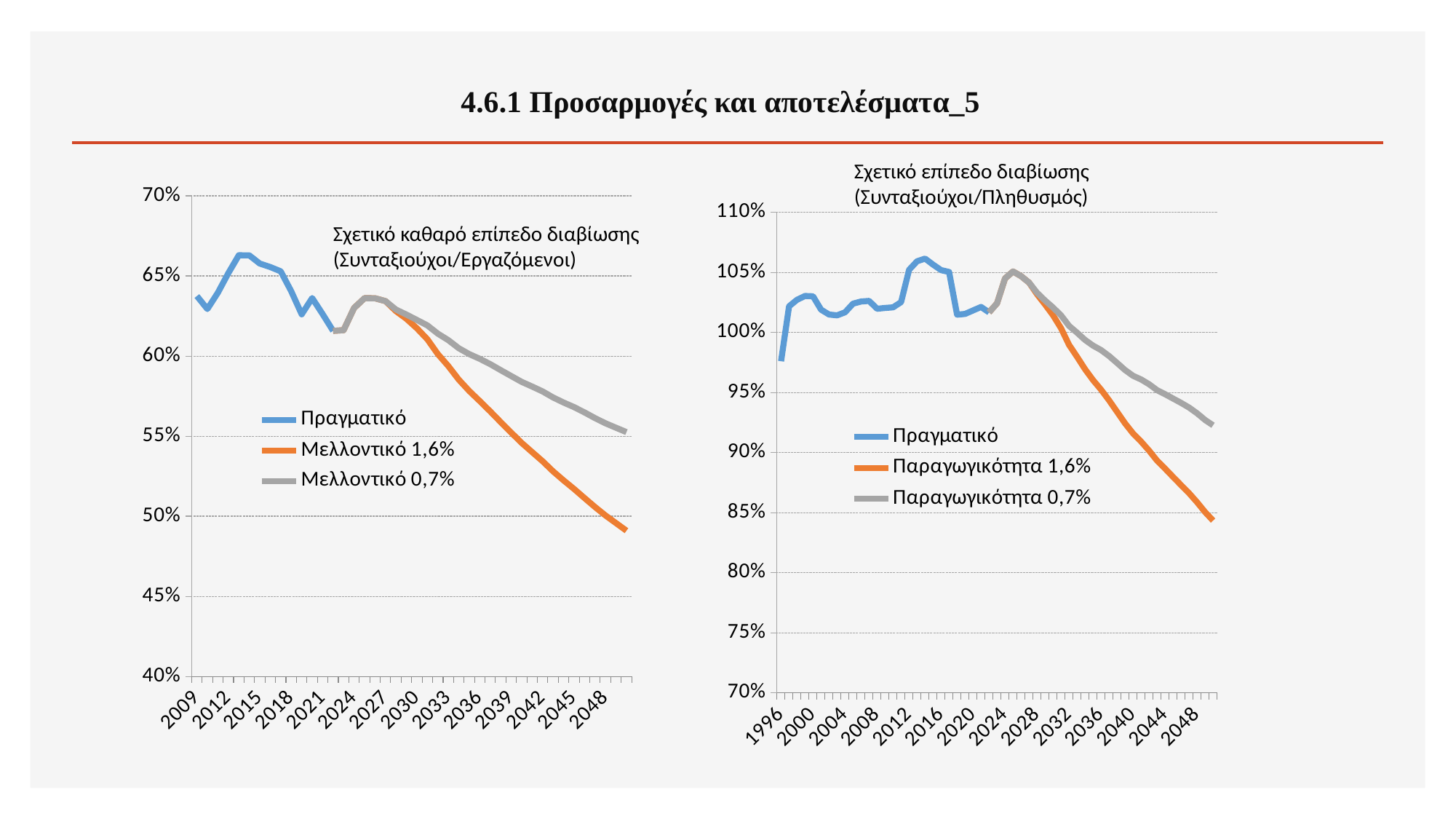
In the left chart (Σχετικό καθαρό επίπεδο διαβίωσης), is the final value of the Μελλοντικό 0,7% series greater or less than 60%? less In the right chart (Σχετικό επίπεδο διαβίωσης), is the final value of the Παραγωγικότητα 0,7% series greater or less than 90%? greater What kind of chart is the left chart (Σχετικό καθαρό επίπεδο διαβίωσης)? Line chart How many series does the legend of the right chart (Σχετικό επίπεδο διαβίωσης) list? 3 How many series does the legend of the left chart (Σχετικό καθαρό επίπεδο διαβίωσης) list? 3 In the left chart (Σχετικό καθαρό επίπεδο διαβίωσης), which series is higher in 2048: Μελλοντικό 1,6% or Μελλοντικό 0,7%? Μελλοντικό 0,7% In the right chart (Σχετικό επίπεδο διαβίωσης), is the final value of the Παραγωγικότητα 1,6% series greater or less than 90%? less In the left chart (Σχετικό καθαρό επίπεδο διαβίωσης), do the projected series rise or fall from 2027 to 2048? fall In the left chart (Σχετικό καθαρό επίπεδο διαβίωσης), which series is shown in orange? Μελλοντικό 1,6%